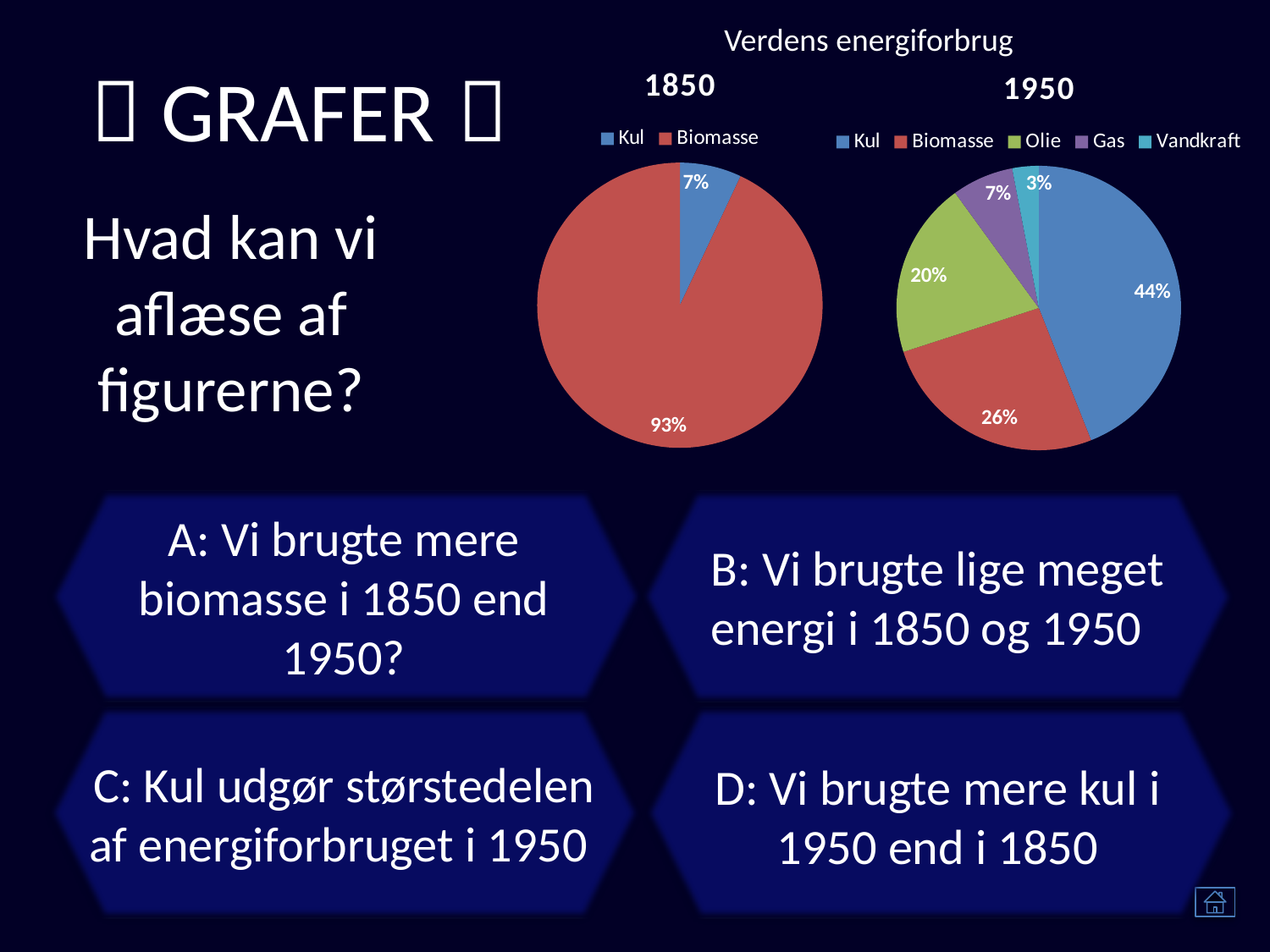
In the 1950 pie chart, what share does Olie have? 20% In the 1950 pie chart, what share does Kul have? 44% In the 1850 pie chart, what share does Biomasse have? 93% How many slices does the 1850 pie chart have? 2 In the 1950 pie chart, which is larger, Olie or Gas? Olie In the 1950 pie chart, what is the difference in percentage points between Kul and Biomasse? 18 How many categories does the legend of the 1950 pie chart list? 5 What type of chart is used for the 1850 data? Pie chart In the 1850 pie chart, what share does Kul have? 7% In the 1950 pie chart, which category has the largest share? Kul In the 1950 pie chart, which category has the smallest share? Vandkraft In the 1950 pie chart, what share does Vandkraft have? 3%